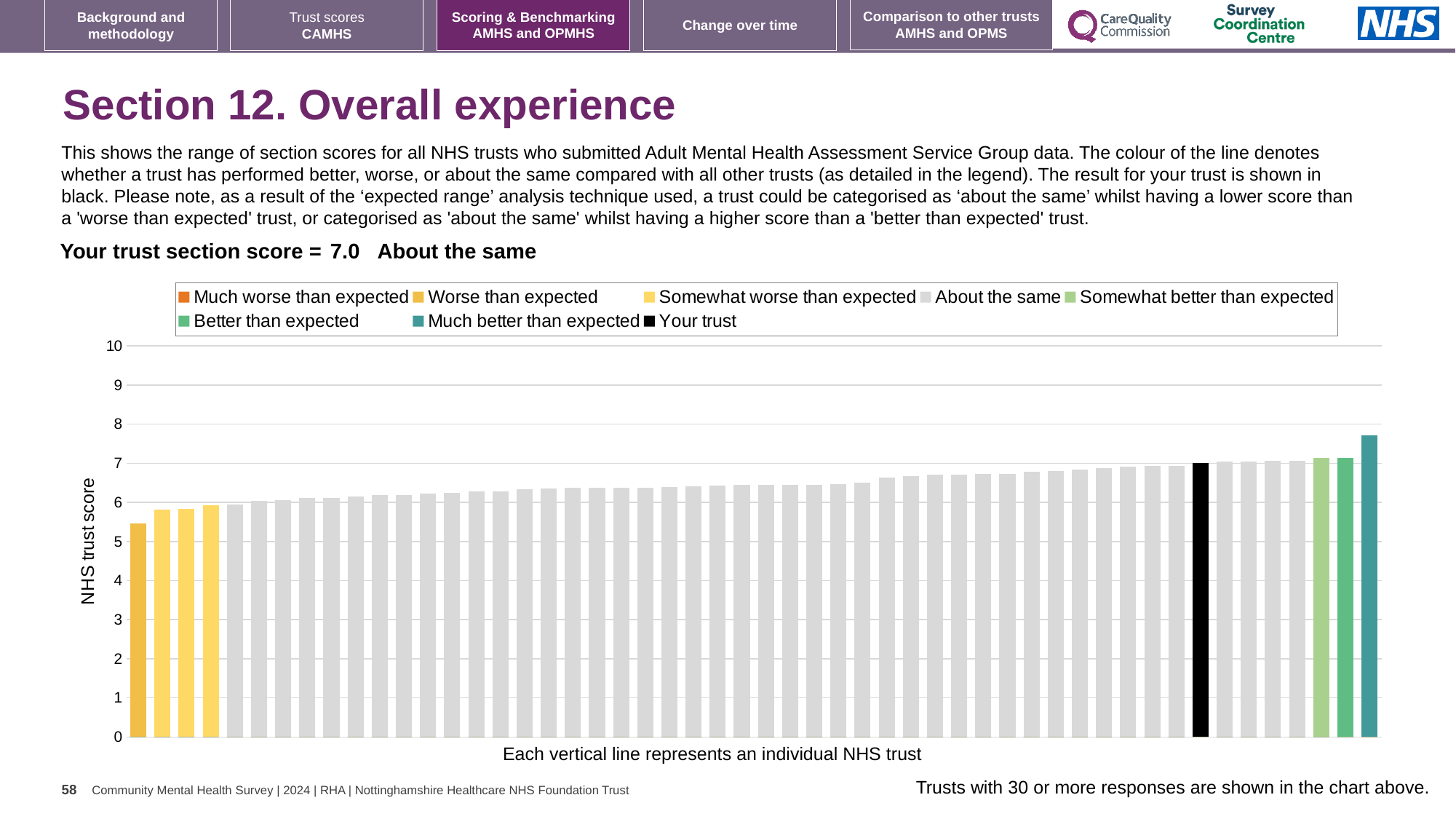
Which is larger: the value of the 'Your trust' bar or the value of the leftmost bar? Your trust Is the value of the tallest bar in the chart greater or less than 7? greater Is the value of the lowest bar in the chart greater or less than 6? less What is the section score for your trust shown on the slide? 7.0 How many entries does the chart legend list? 8 What kind of chart is shown on the slide? Bar chart Is the value of the black 'Your trust' bar greater or less than 5? greater How many bars are coloured as 'Somewhat better than expected'? 1 Do the bar values rise or fall from left to right along the x axis? Rise What is the label on the vertical axis of the chart? NHS trust score Which legend category does the tallest bar in the chart belong to? Much better than expected Which category is your trust placed in for this section? About the same